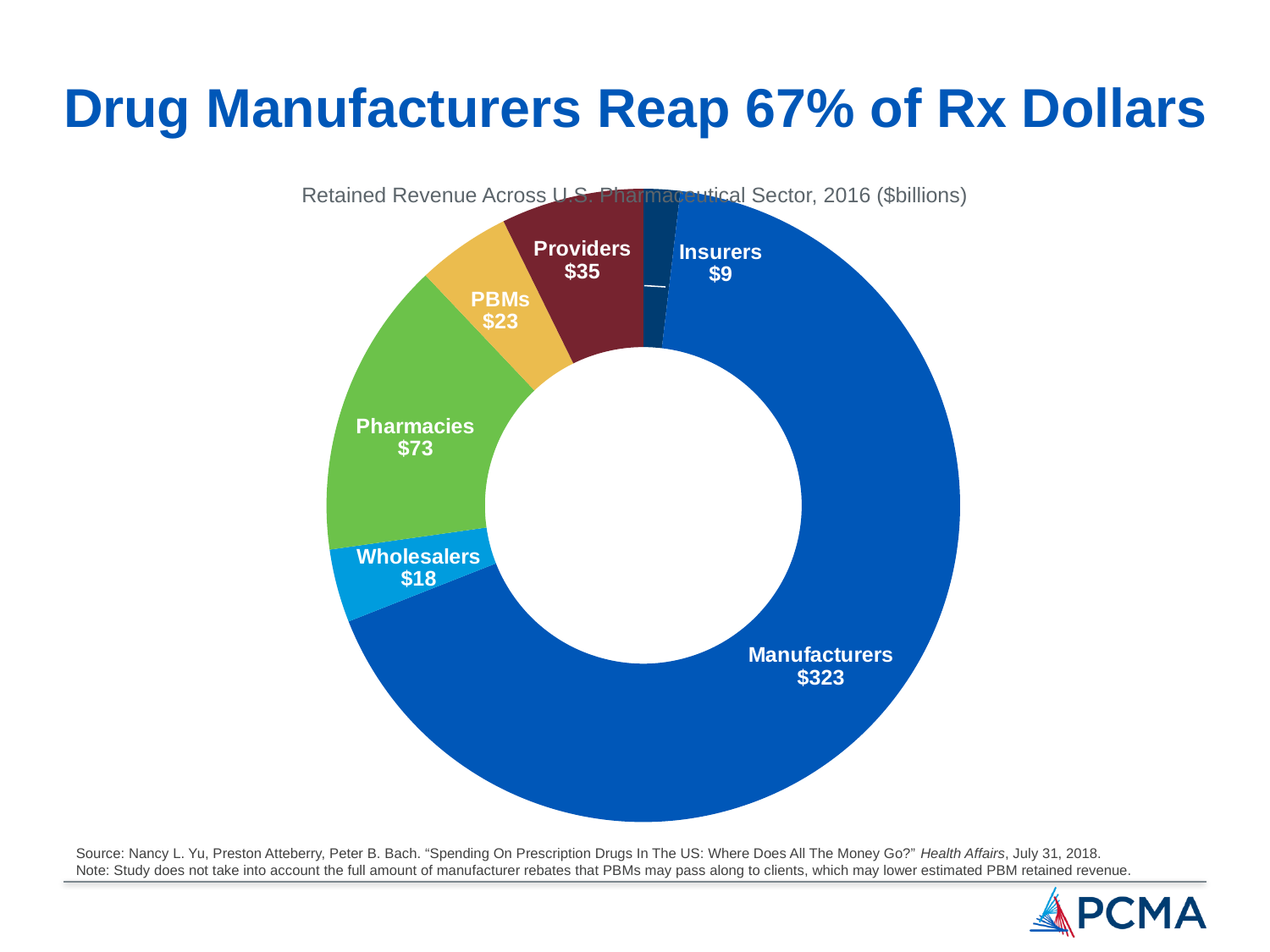
Which has a larger retained revenue, Providers or Wholesalers? Providers Which sector has the largest retained revenue? Manufacturers Which sector has the smallest retained revenue? Insurers What is the retained revenue for Manufacturers? $323 What kind of chart is shown on the slide? Doughnut chart How many sectors are shown in the chart? 6 What is the retained revenue for PBMs? $23 What is the difference in retained revenue between Pharmacies and Providers? $38 What is the retained revenue for Pharmacies? $73 What share of Rx dollars do Manufacturers reap, according to the slide? 67% What is the difference in retained revenue between PBMs and Wholesalers? $5 What is the retained revenue for Insurers? $9